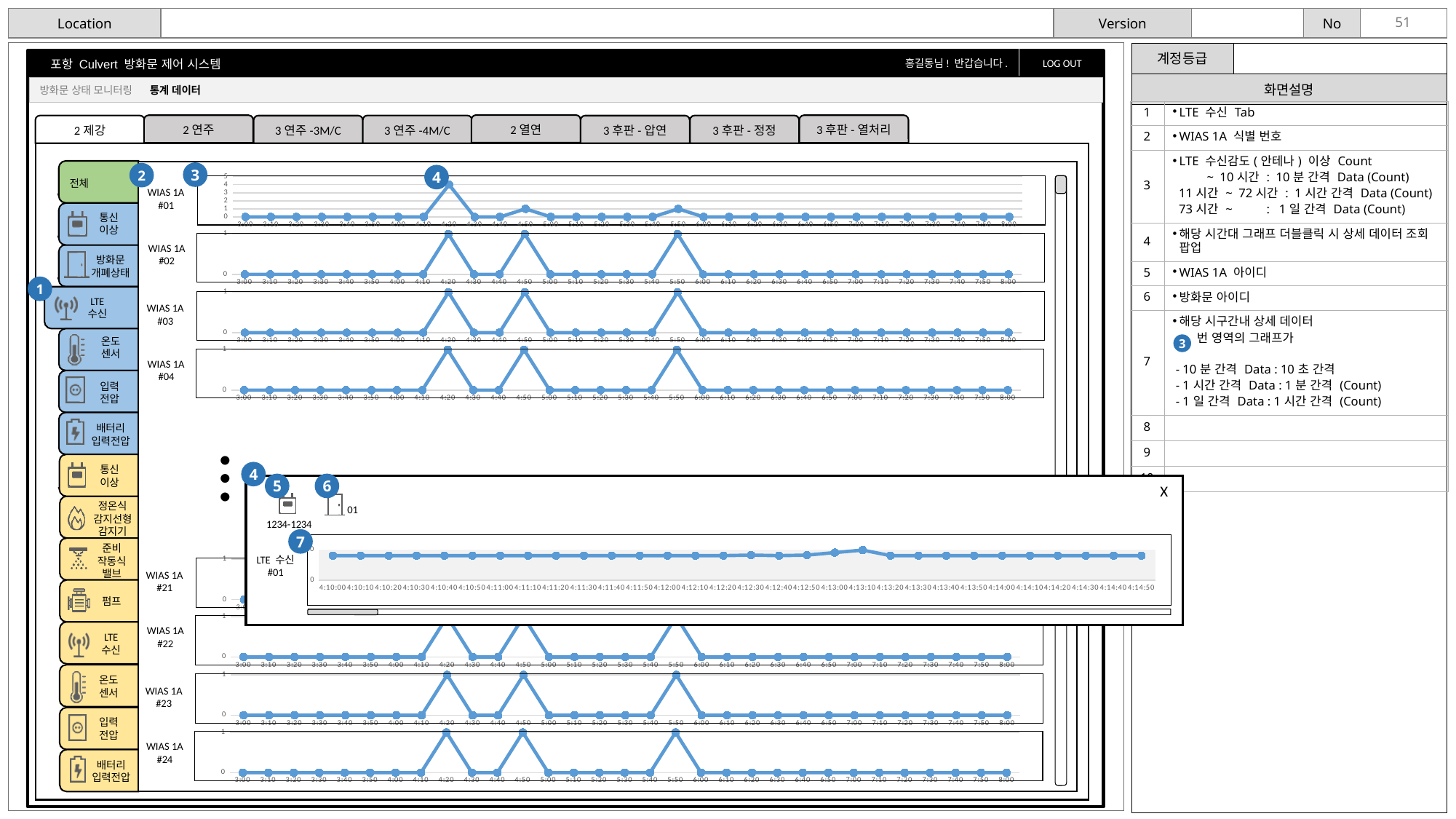
What kind of chart is shown in the popup labelled LTE 수신 #01? line chart What is the first time label on the x axis of the WIAS 1A #24 chart? 3:00 In the WIAS 1A #01 chart, at which time does the line reach its highest value? 4:20 In the WIAS 1A #01 chart, is the value at 4:50 greater or less than 3? less What is the highest tick shown on the y axis of the WIAS 1A #01 chart? 5 In the WIAS 1A #02 chart, what is the value at 3:00? 0 What is the last time label on the x axis of the WIAS 1A #24 chart? 8:00 In the WIAS 1A #02 chart, what value does the line reach at 4:20? 1 What kind of chart is the WIAS 1A #01 chart at the top of the slide? line chart In the WIAS 1A #04 chart, how many times does the line rise to 1? 3 In the WIAS 1A #01 chart, is the value at 4:20 greater or less than 3? greater In the WIAS 1A #03 chart, which is larger, the value at 4:50 or the value at 5:00? 4:50